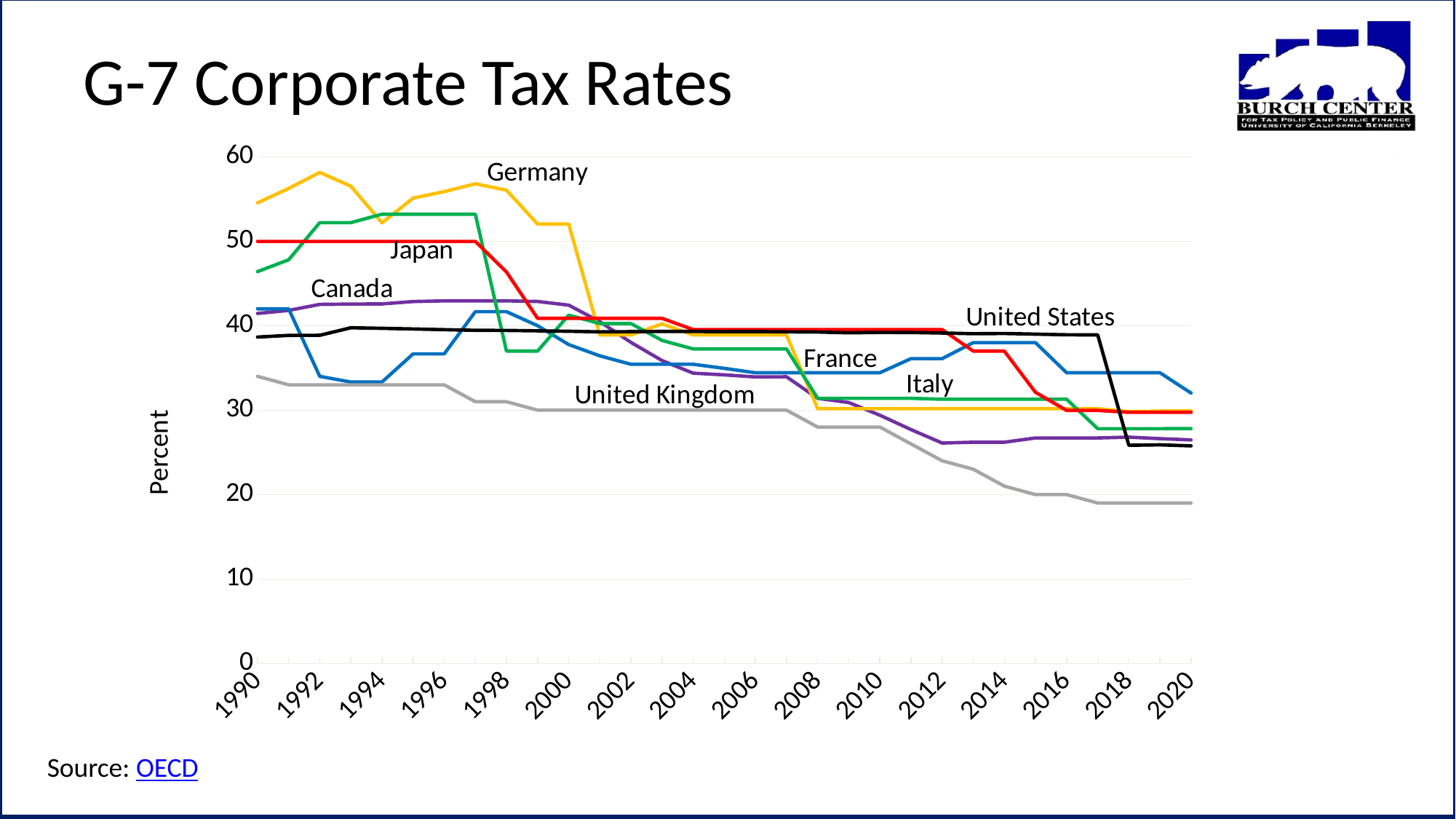
Is the value for the United States in 2020 greater or less than 30? less What is the label on the vertical axis of the chart? Percent Which country had the lowest corporate tax rate in 1990? United Kingdom Does the United Kingdom's corporate tax rate generally rise or fall from 1990 to 2020? Fall How many countries' lines are plotted on the chart? 7 In 2010, which had the larger corporate tax rate, the United States or the United Kingdom? United States Which country had the highest corporate tax rate in 1990? Germany Which country had the lowest corporate tax rate in 2020? United Kingdom What kind of chart is shown on the slide? Line chart What is the title of the chart on the slide? G-7 Corporate Tax Rates Is the value for France in 2020 greater or less than 30? greater Is the value for Germany in 1992 greater or less than 50? greater